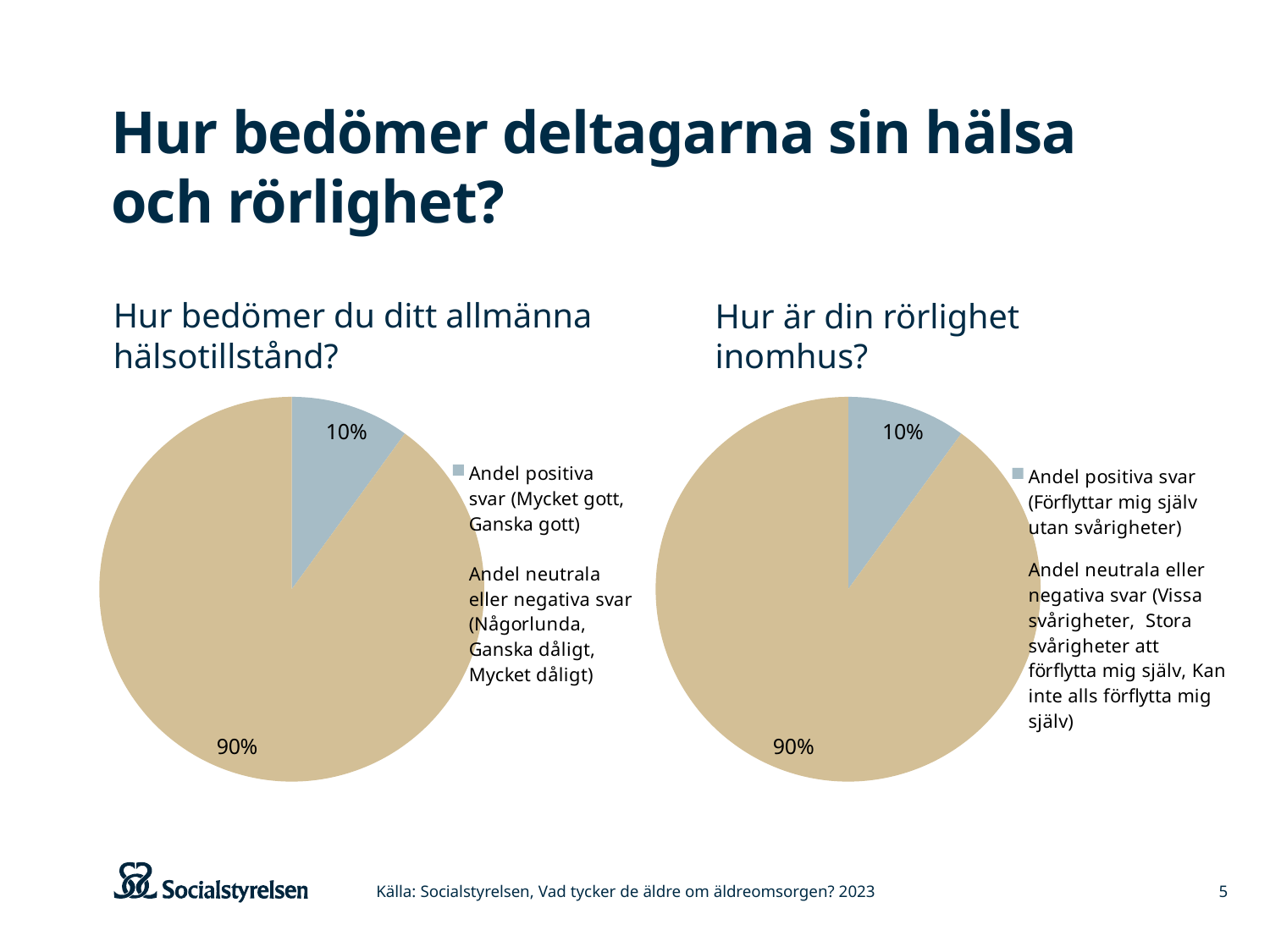
In the left chart 'Hur bedömer du ditt allmänna hälsotillstånd?', what colour is the slice for 'Andel positiva svar'? Blue-grey In the right chart 'Hur är din rörlighet inomhus?', what share is labelled for 'Andel neutrala eller negativa svar'? 90% In the left chart 'Hur bedömer du ditt allmänna hälsotillstånd?', what share is labelled for 'Andel positiva svar'? 10% In the left chart 'Hur bedömer du ditt allmänna hälsotillstånd?', which category has the largest slice? Andel neutrala eller negativa svar In the right chart 'Hur är din rörlighet inomhus?', what share is labelled for 'Andel positiva svar'? 10% In the left chart 'Hur bedömer du ditt allmänna hälsotillstånd?', what is the difference in percentage points between the two slices? 80 In the right chart 'Hur är din rörlighet inomhus?', which is larger: the share of positive answers or the share of neutral or negative answers? Andel neutrala eller negativa svar In the left chart 'Hur bedömer du ditt allmänna hälsotillstånd?', what share is labelled for 'Andel neutrala eller negativa svar'? 90% What kind of chart is used on the left of the slide? Pie chart How many slices does the right chart 'Hur är din rörlighet inomhus?' have? 2 How many charts are shown on the slide? 2 In the right chart 'Hur är din rörlighet inomhus?', which category has the smallest slice? Andel positiva svar